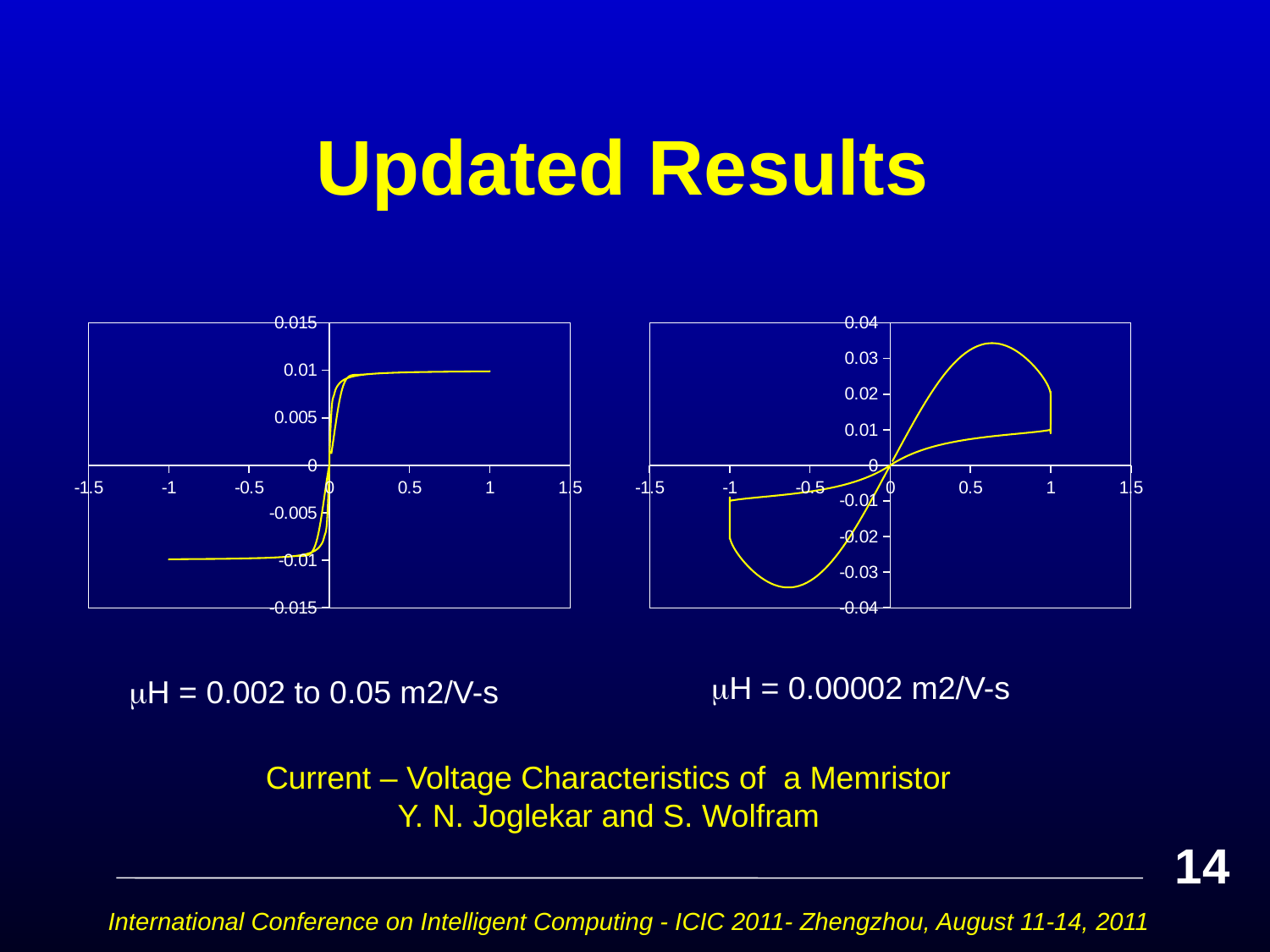
In the left chart (μH = 0.002 to 0.05 m2/V-s), do the plotted values rise or fall as x increases from -1 to 1? rise How many charts are shown on the slide? 2 In the right chart (μH = 0.00002 m2/V-s), is the value of the upper branch at x = 0.5 greater or less than 0.02? greater What is the maximum value shown on the y axis of the left chart (μH = 0.002 to 0.05 m2/V-s)? 0.015 What kind of chart is the left chart on the slide? line chart What kind of chart is the right chart on the slide? line chart In the left chart (μH = 0.002 to 0.05 m2/V-s), is the value at x = -0.5 greater or less than -0.005? less What is the maximum value shown on the y axis of the right chart (μH = 0.00002 m2/V-s)? 0.04 In the right chart (μH = 0.00002 m2/V-s), is the lowest point of the curve greater or less than -0.03? less